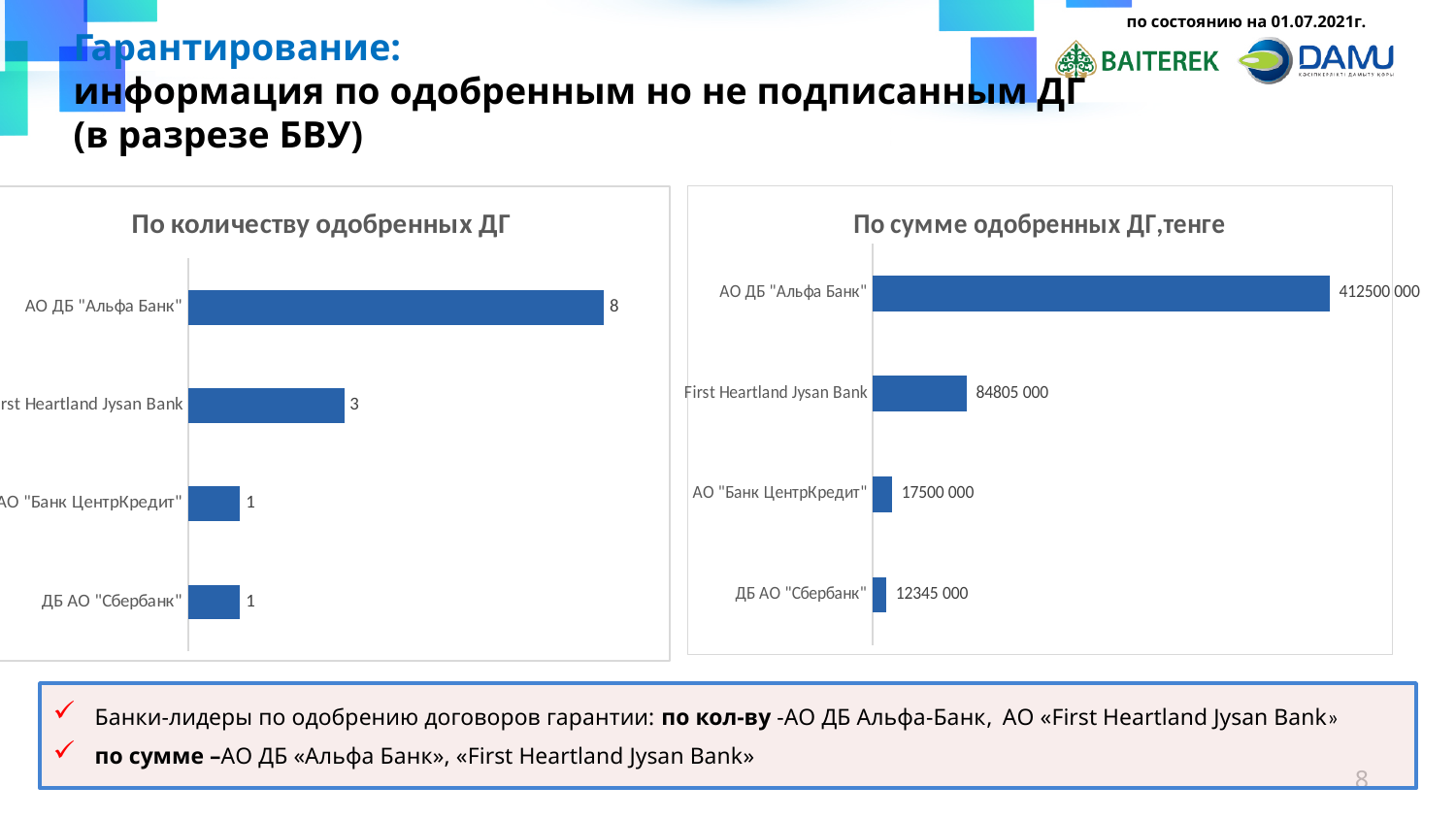
In the chart "По количеству одобренных ДГ", what is the difference between АО ДБ "Альфа Банк" and First Heartland Jysan Bank? 5 In the chart "По количеству одобренных ДГ", what is the value for First Heartland Jysan Bank? 3 In the chart "По сумме одобренных ДГ,тенге", what is the value for ДБ АО "Сбербанк"? 12345 000 In the chart "По количеству одобренных ДГ", which bank has the highest value? АО ДБ "Альфа Банк" What is the title of the chart on the left side of the slide? По количеству одобренных ДГ In the chart "По количеству одобренных ДГ", what is the value for АО ДБ "Альфа Банк"? 8 What type of chart is "По сумме одобренных ДГ,тенге"? Bar chart In the chart "По сумме одобренных ДГ,тенге", which is larger: First Heartland Jysan Bank or АО "Банк ЦентрКредит"? First Heartland Jysan Bank In the chart "По сумме одобренных ДГ,тенге", what is the value for АО ДБ "Альфа Банк"? 412500 000 In the chart "По сумме одобренных ДГ,тенге", which bank has the lowest value? ДБ АО "Сбербанк" In the chart "По количеству одобренных ДГ", how many banks are shown? 4 In the chart "По сумме одобренных ДГ,тенге", what is the value for АО "Банк ЦентрКредит"? 17500 000